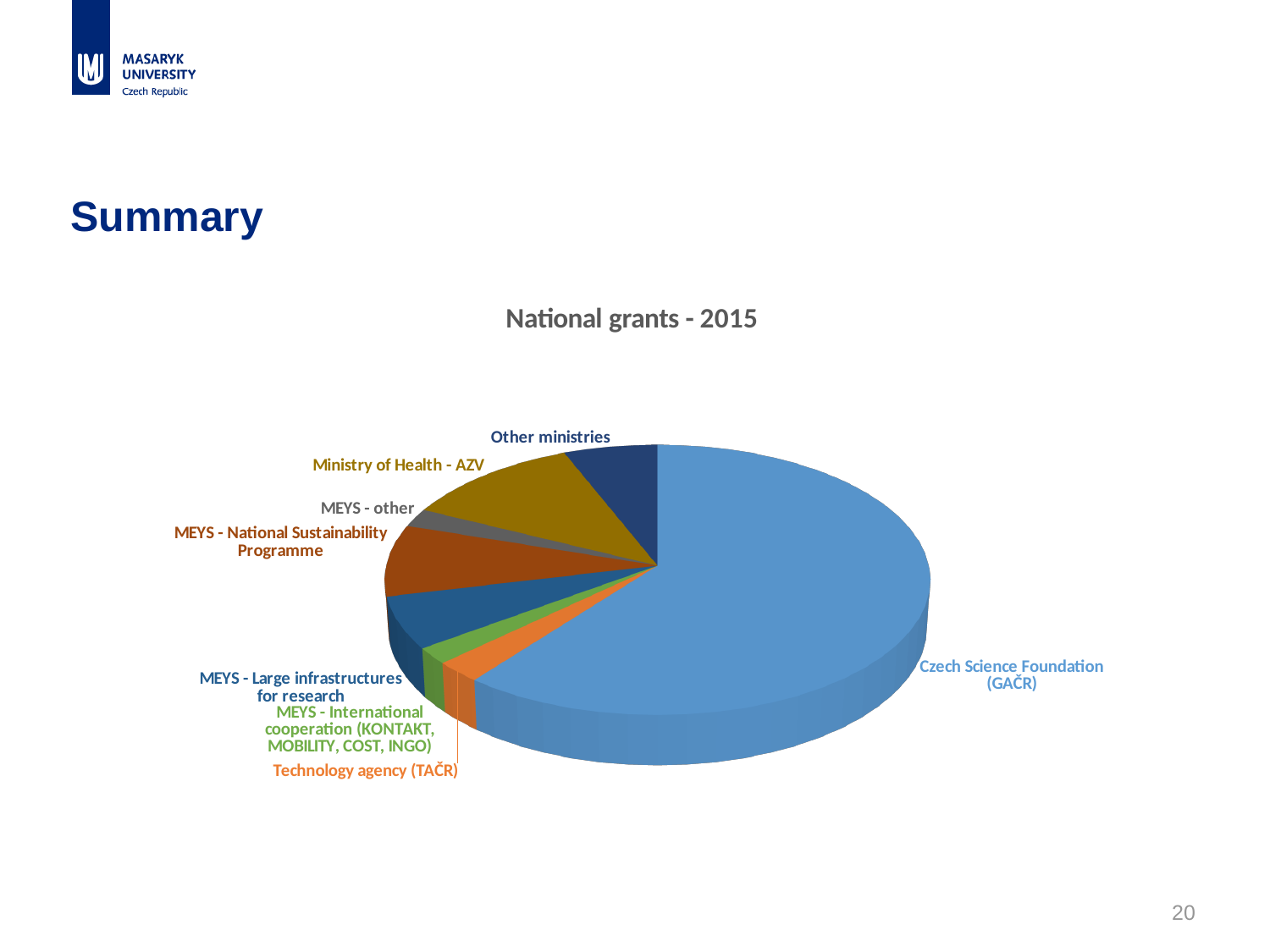
What kind of chart is shown on the slide? Pie chart Which is larger, the slice for Other ministries or the slice for Technology agency (TAČR)? Other ministries Which year does the chart cover? 2015 What is the title of the chart? National grants - 2015 Which is larger, the slice for MEYS - National Sustainability Programme or the slice for MEYS - International cooperation (KONTAKT, MOBILITY, COST, INGO)? MEYS - National Sustainability Programme Which is larger, the slice for Ministry of Health - AZV or the slice for MEYS - other? Ministry of Health - AZV Which category has the largest slice of the pie? Czech Science Foundation (GAČR) How many slices does the pie chart have? 8